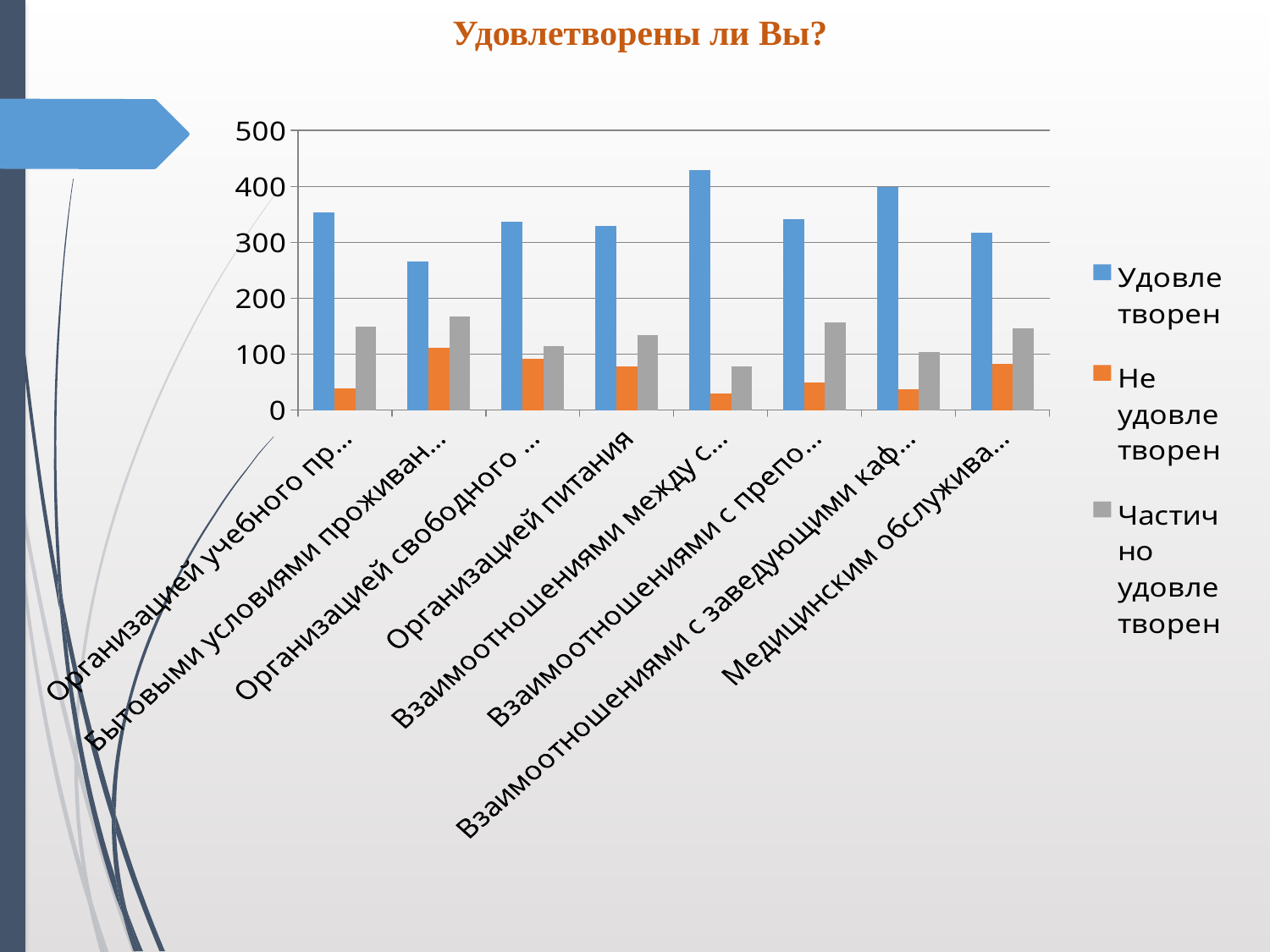
Which colour represents the series "Не удовлетворен"? orange How many series does the legend list? 3 Which category has the highest "Удовлетворен" bar? the fifth category (Взаимоотношениями между с…) Is the "Не удовлетворен" value for "Организацией питания" greater or less than 100? less Is the "Частично удовлетворен" value for "Организацией питания" greater or less than 100? greater How many categories are plotted along the x axis? 8 Which category has the lowest "Удовлетворен" bar? the second category (Бытовыми условиями прожива…) For "Организацией питания", which is larger: "Удовлетворен" or "Частично удовлетворен"? Удовлетворен What kind of chart is shown on the slide? bar chart For "Организацией питания", which is larger: "Не удовлетворен" or "Частично удовлетворен"? Частично удовлетворен What is the title of the chart? Удовлетворены ли Вы? Is the "Удовлетворен" value for "Организацией питания" greater or less than 300? greater